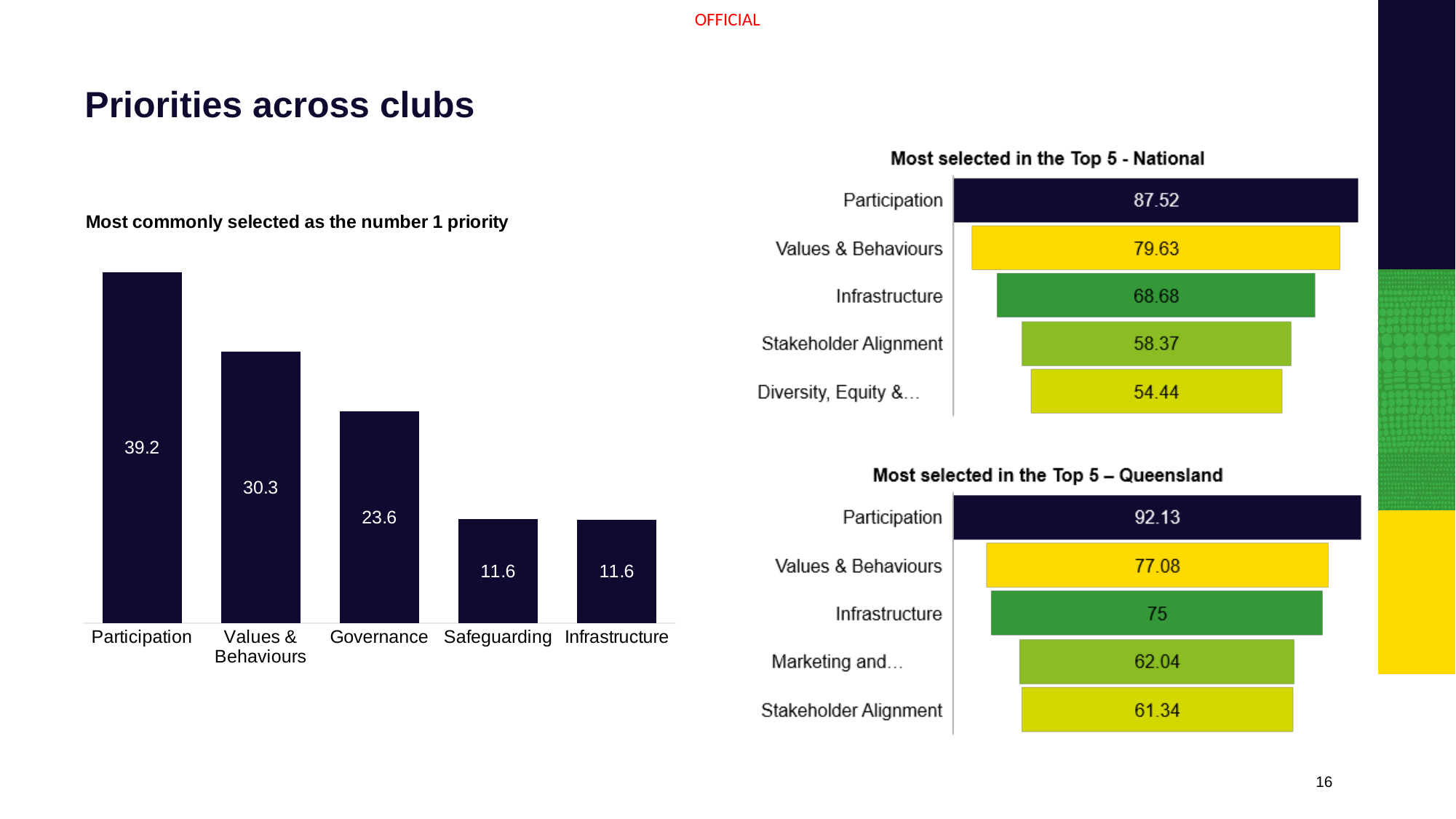
In the 'Most selected in the Top 5 - National' chart, what is the difference between Participation and Values & Behaviours? 7.89 What kind of chart is 'Most commonly selected as the number 1 priority'? Bar chart In the 'Most selected in the Top 5 - National' chart, what is the value for Infrastructure? 68.68 In the 'Most selected in the Top 5 - National' chart, which category has the lowest value? Diversity, Equity &... Which is larger: Participation in the 'Most selected in the Top 5 – Queensland' chart or Participation in the 'Most selected in the Top 5 - National' chart? Queensland In the 'Most selected in the Top 5 – Queensland' chart, what is the value for Marketing and...? 62.04 In the 'Most commonly selected as the number 1 priority' chart, which category has the highest value? Participation In the 'Most commonly selected as the number 1 priority' chart, what is the difference between Participation and Values & Behaviours? 8.9 In the 'Most commonly selected as the number 1 priority' chart, how many categories are shown? 5 In the 'Most selected in the Top 5 – Queensland' chart, what is the difference between Participation and Stakeholder Alignment? 30.79 In the 'Most selected in the Top 5 – Queensland' chart, which is larger: Infrastructure or Stakeholder Alignment? Infrastructure In the 'Most commonly selected as the number 1 priority' chart, what is the value for Governance? 23.6